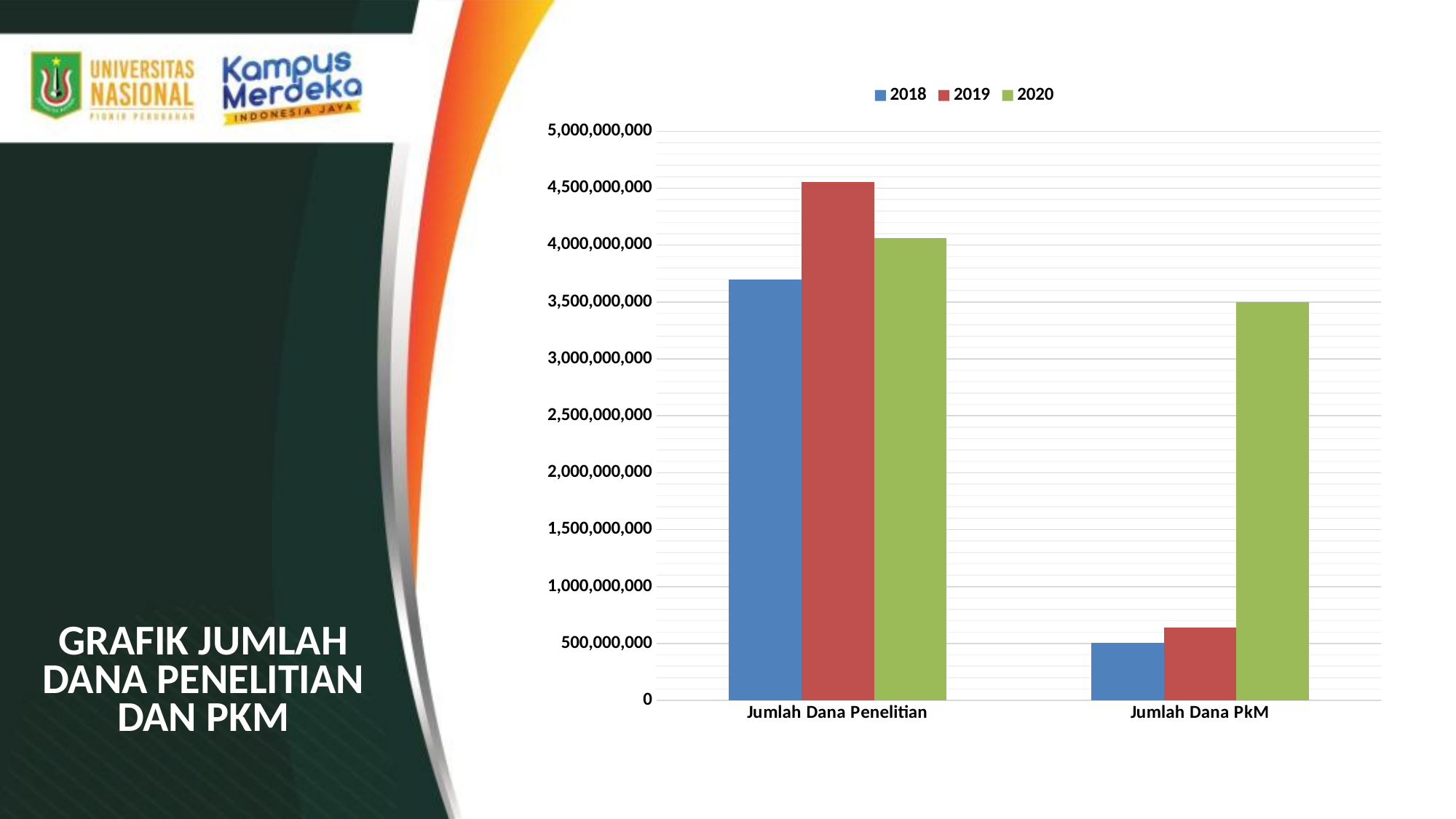
Which is larger: the 2020 value for Jumlah Dana Penelitian or the 2020 value for Jumlah Dana PkM? Jumlah Dana Penelitian Is the 2018 value for Jumlah Dana Penelitian greater or less than 3,500,000,000? greater How many categories are shown on the x axis? 2 Which year has the highest value for Jumlah Dana PkM? 2020 What kind of chart is shown on the slide? bar chart Which year has the lowest value for Jumlah Dana PkM? 2018 How many series does the legend list? 3 Which year has the lowest value for Jumlah Dana Penelitian? 2018 Is the 2019 value for Jumlah Dana PkM greater or less than 1,000,000,000? less Which year has the highest value for Jumlah Dana Penelitian? 2019 Is the 2020 value for Jumlah Dana PkM greater or less than 3,000,000,000? greater Do the values for Jumlah Dana PkM rise or fall from 2018 to 2020? rise